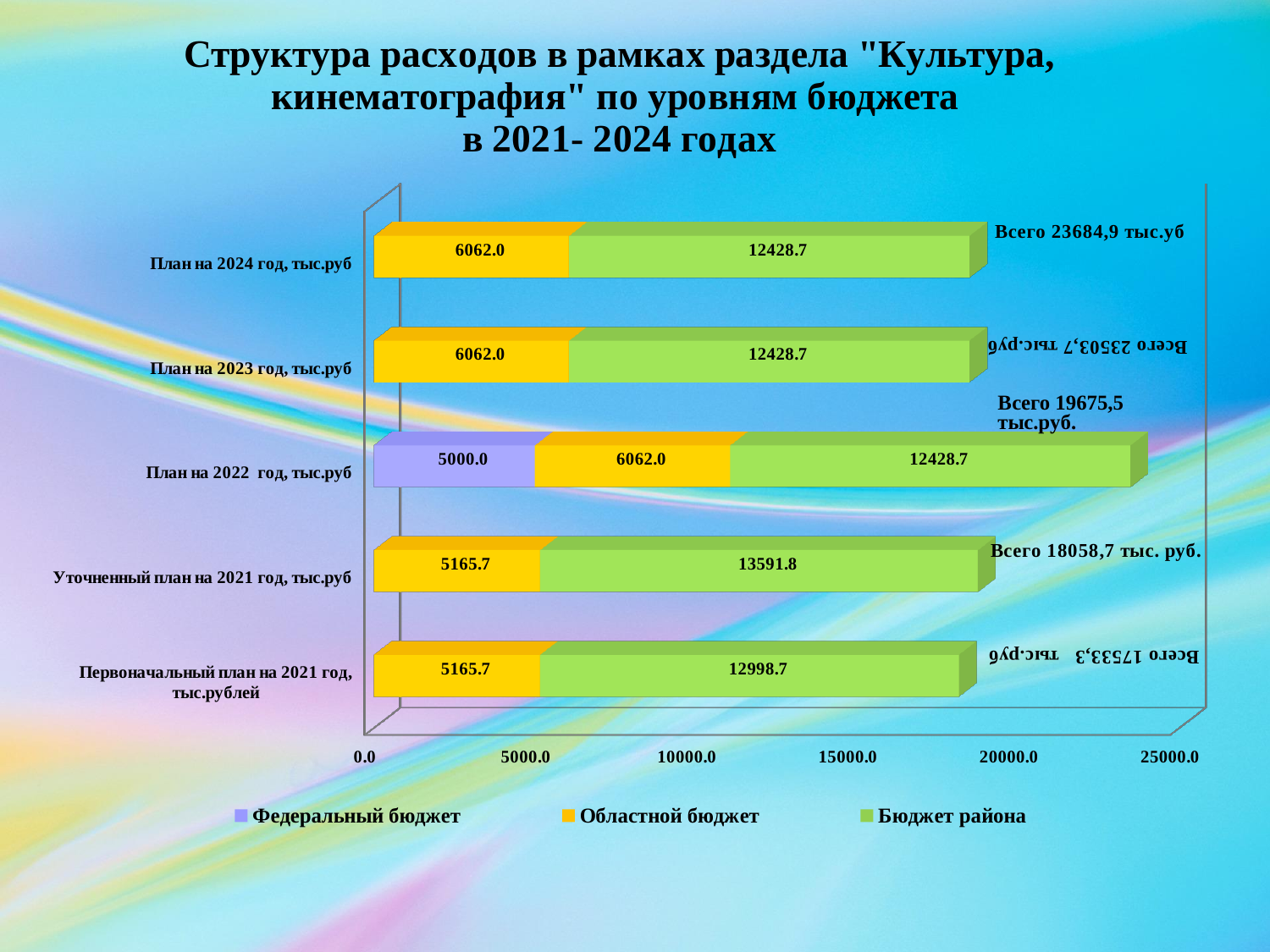
What is the difference between Бюджет района for Уточненный план на 2021 год and Первоначальный план на 2021 год? 593.1 Which category has the highest value for Бюджет района? Уточненный план на 2021 год, тыс.руб How many series does the legend list? 3 Which category is the only one with a Федеральный бюджет segment? План на 2022 год, тыс.руб What is the value of Бюджет района for Первоначальный план на 2021 год? 12998.7 Which is larger: Областной бюджет for План на 2023 год or for Уточненный план на 2021 год? План на 2023 год What kind of chart is shown on the slide? Stacked bar chart What is the value of Бюджет района for План на 2024 год? 12428.7 How many categories (plan rows) are shown on the chart? 5 What is the value of Областной бюджет for Уточненный план на 2021 год? 5165.7 What colour represents Областной бюджет in the legend? Yellow What is the value of Федеральный бюджет for План на 2022 год? 5000.0